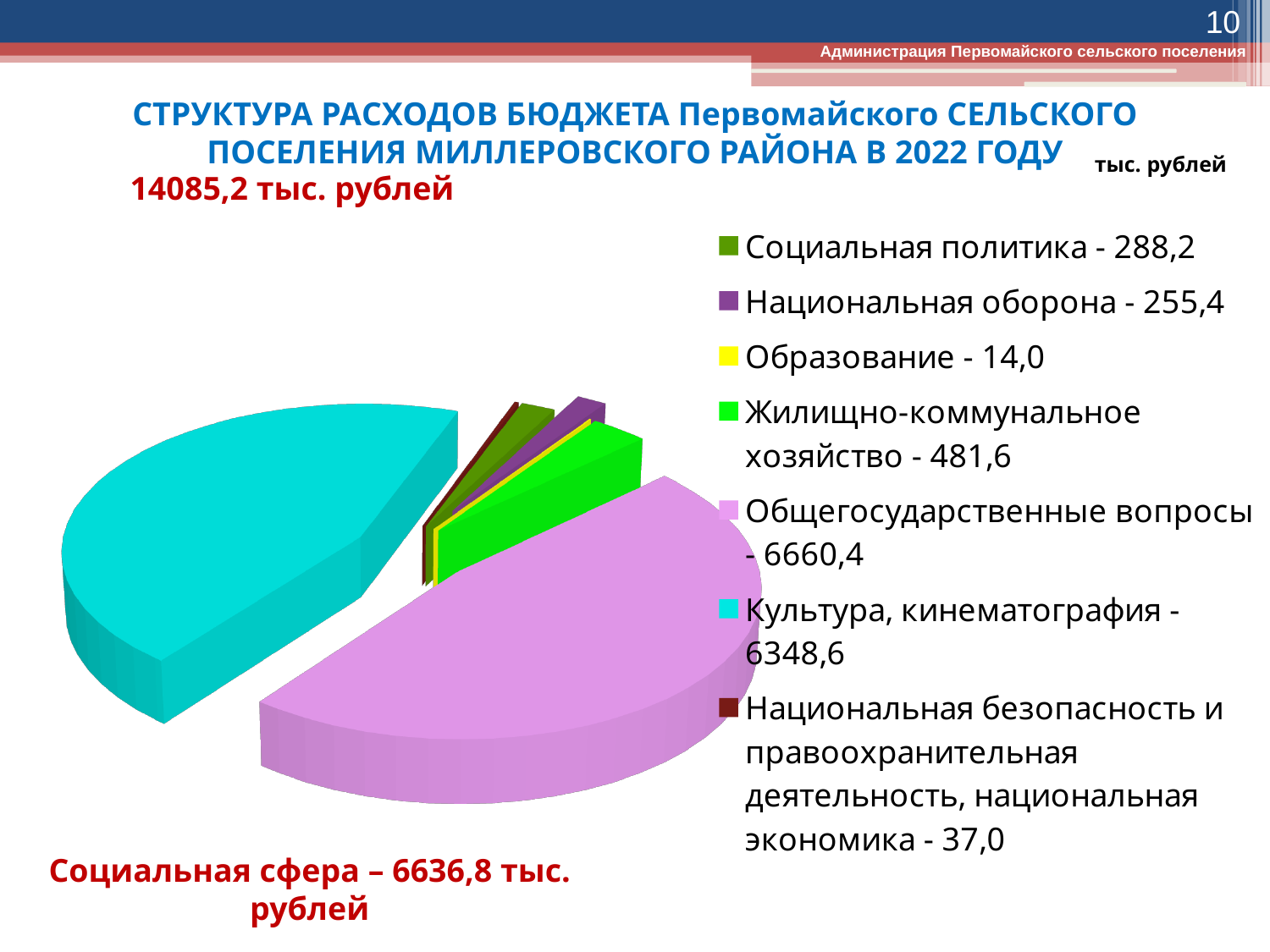
Which category has the largest value? Общегосударственные вопросы What is the value for Национальная оборона? 255,4 What colour is the slice for Культура, кинематография? Cyan What kind of chart is shown on the slide? Pie chart What is the value for Жилищно-коммунальное хозяйство? 481,6 What is the value for Образование? 14,0 Which category has the smallest value? Образование What is the value for Культура, кинематография? 6348,6 What is the value for Общегосударственные вопросы? 6660,4 What is the difference between Общегосударственные вопросы and Культура, кинематография? 311,8 How many categories does the pie chart show? 7 Which is larger, Социальная политика or Национальная оборона? Социальная политика